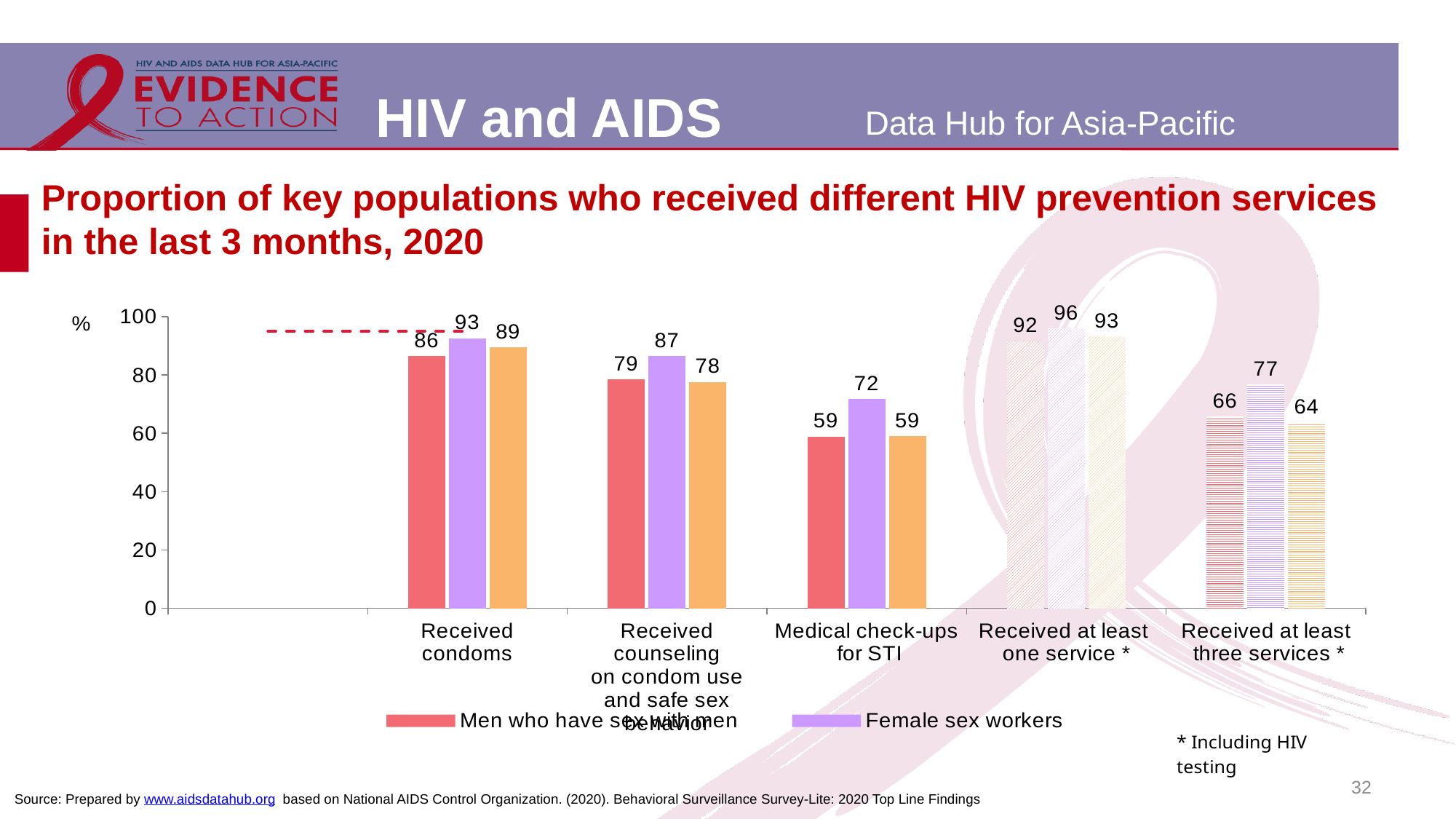
For men who have sex with men, which is larger: the value for 'Received condoms' or for 'Received counseling on condom use and safe sex behavior'? Received condoms What year does the chart title refer to? 2020 For medical check-ups for STI, how much higher is the value for female sex workers than for men who have sex with men? 13 What is the value for men who have sex with men for medical check-ups for STI? 59 What percentage of men who have sex with men received at least one service? 92 What type of chart is shown on the slide? Bar chart For female sex workers, which category has the highest value? Received at least one service * How many service categories are shown on the x axis? 5 For men who have sex with men, which category has the lowest value? Medical check-ups for STI For female sex workers, what is the difference between the value for 'Received condoms' and the value for 'Received counseling on condom use and safe sex behavior'? 6 What is the value for female sex workers for 'Received at least three services'? 77 What percentage of female sex workers received condoms? 93